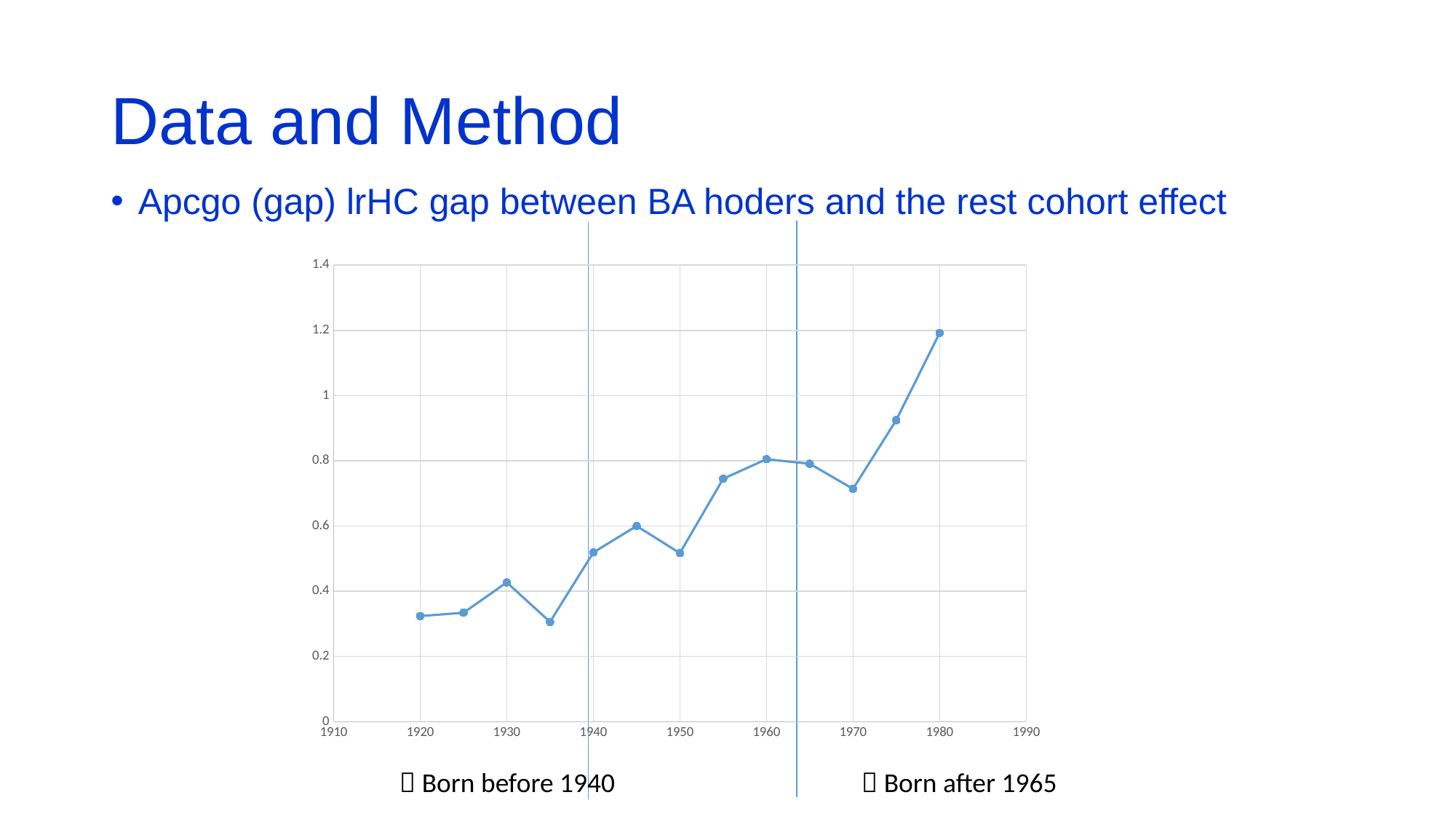
Is the value for 1980 greater or less than 1? greater What is the highest tick value shown on the y axis? 1.4 Is the value for 1920 greater or less than 0.4? less Is the value for 1970 greater or less than 0.8? less Which has the larger value, 1930 or 1935? 1930 Overall, do the values rise or fall from 1920 to 1980? rise How many data points are plotted on the line? 13 What kind of chart is shown on the slide? line chart Which year has the highest plotted value? 1980 Which has the larger value, 1950 or 1955? 1955